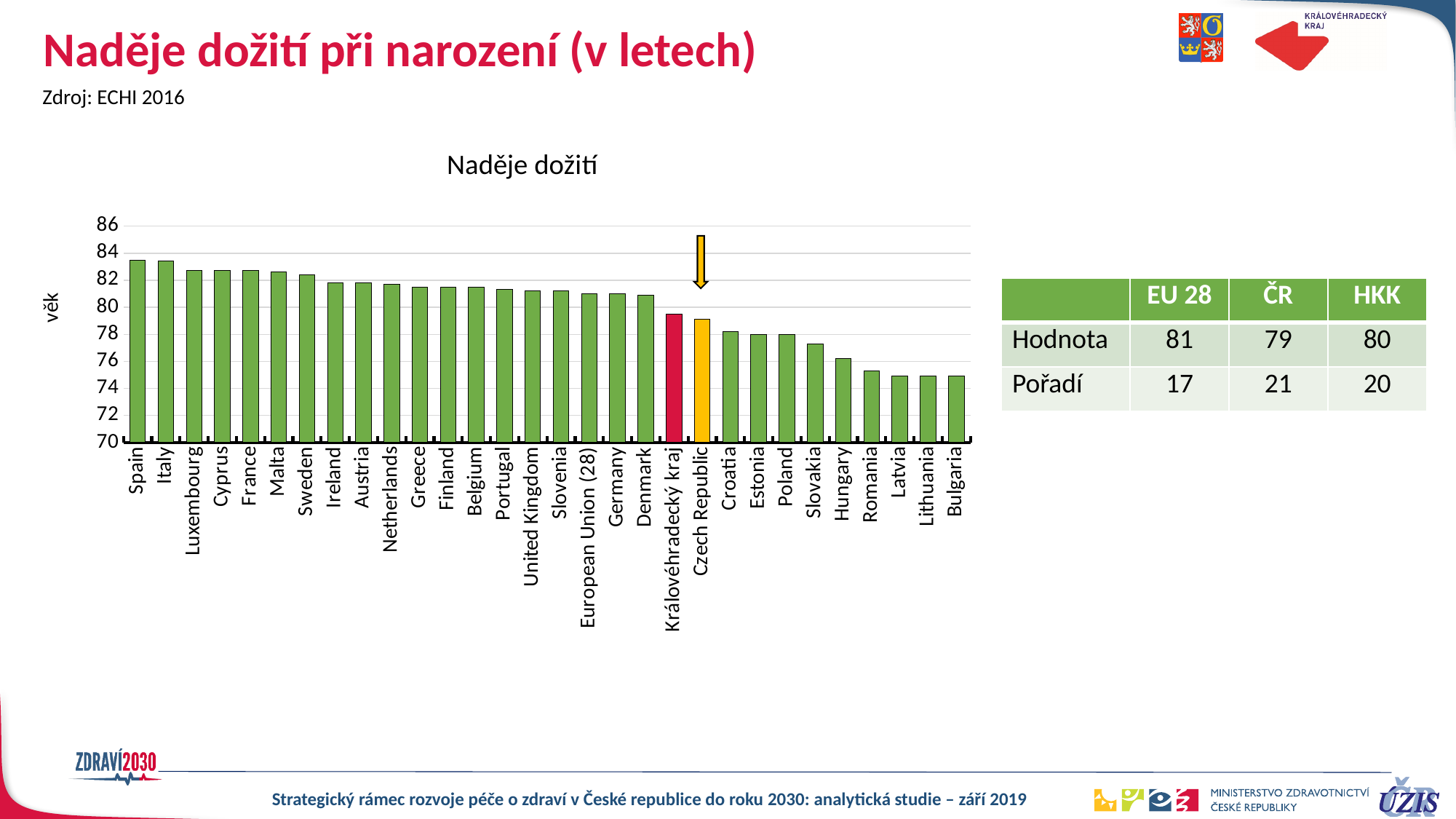
Do the values generally rise or fall from left to right along the x axis? fall What is the title of the chart? Naděje dožití What kind of chart is shown on the slide? bar chart Is the value for Romania greater or less than 76? less Is the value for Královéhradecký kraj greater or less than 80? less Which has the larger value, Sweden or Hungary? Sweden Is the value for Bulgaria greater or less than 76? less Which bar in the chart is coloured red? Královéhradecký kraj How many bars (categories) does the chart show? 30 Which has the larger value, Croatia or Germany? Germany